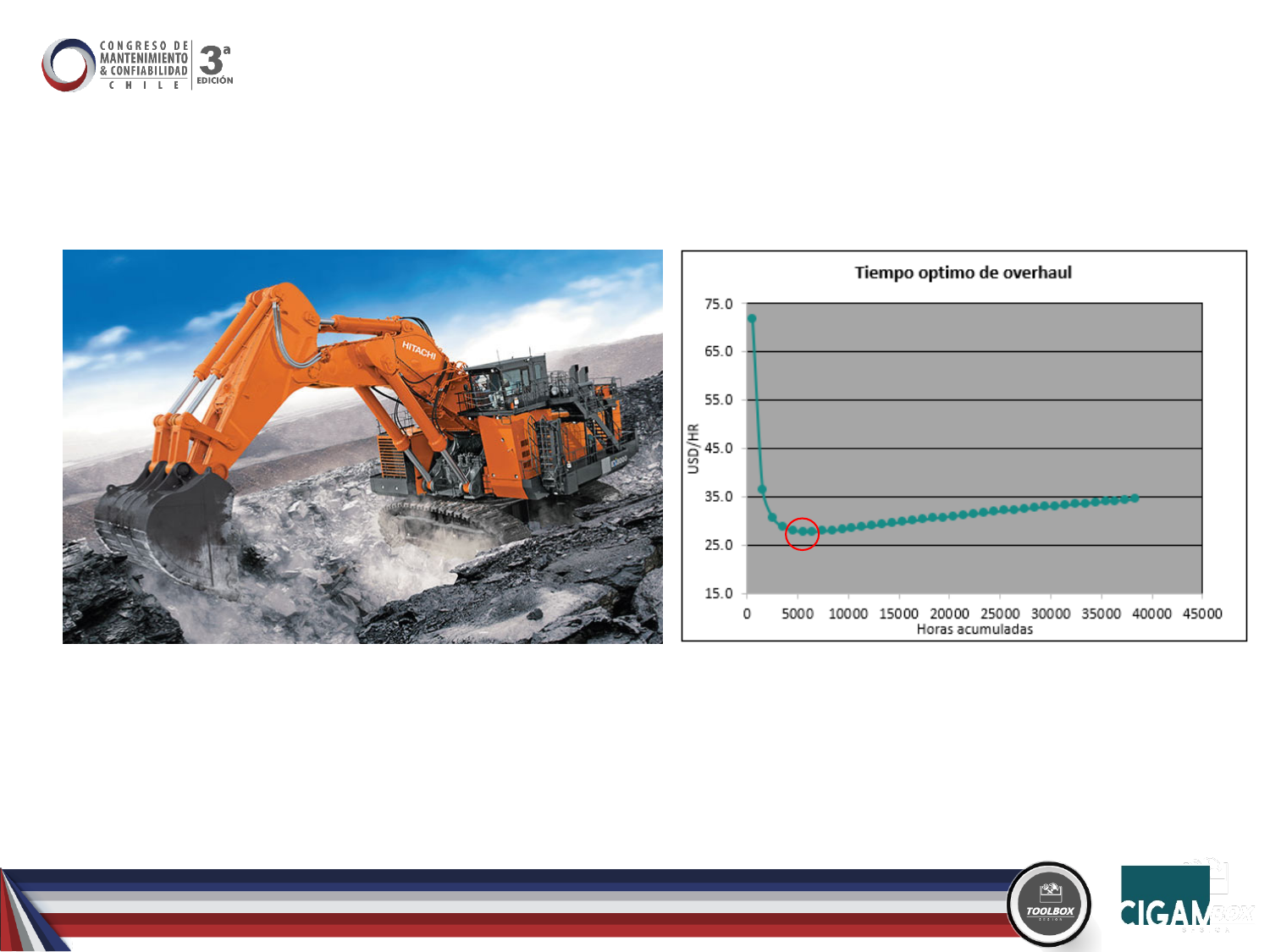
What is the label of the vertical axis of the chart? USD/HR How does the curve behave as accumulated hours increase? It falls sharply at first, then rises slowly Is the value at 30000 accumulated hours greater or less than 35? less Is the value at 5000 accumulated hours greater or less than 35? less Which is larger, the value at 0 accumulated hours or the value at 5000 accumulated hours? 0 accumulated hours What is the title of the chart? Tiempo optimo de overhaul Which is larger, the value at 10000 accumulated hours or the value at 35000 accumulated hours? 35000 accumulated hours What kind of chart is shown on the slide? Line chart Is the value at 35000 accumulated hours greater or less than 25? greater